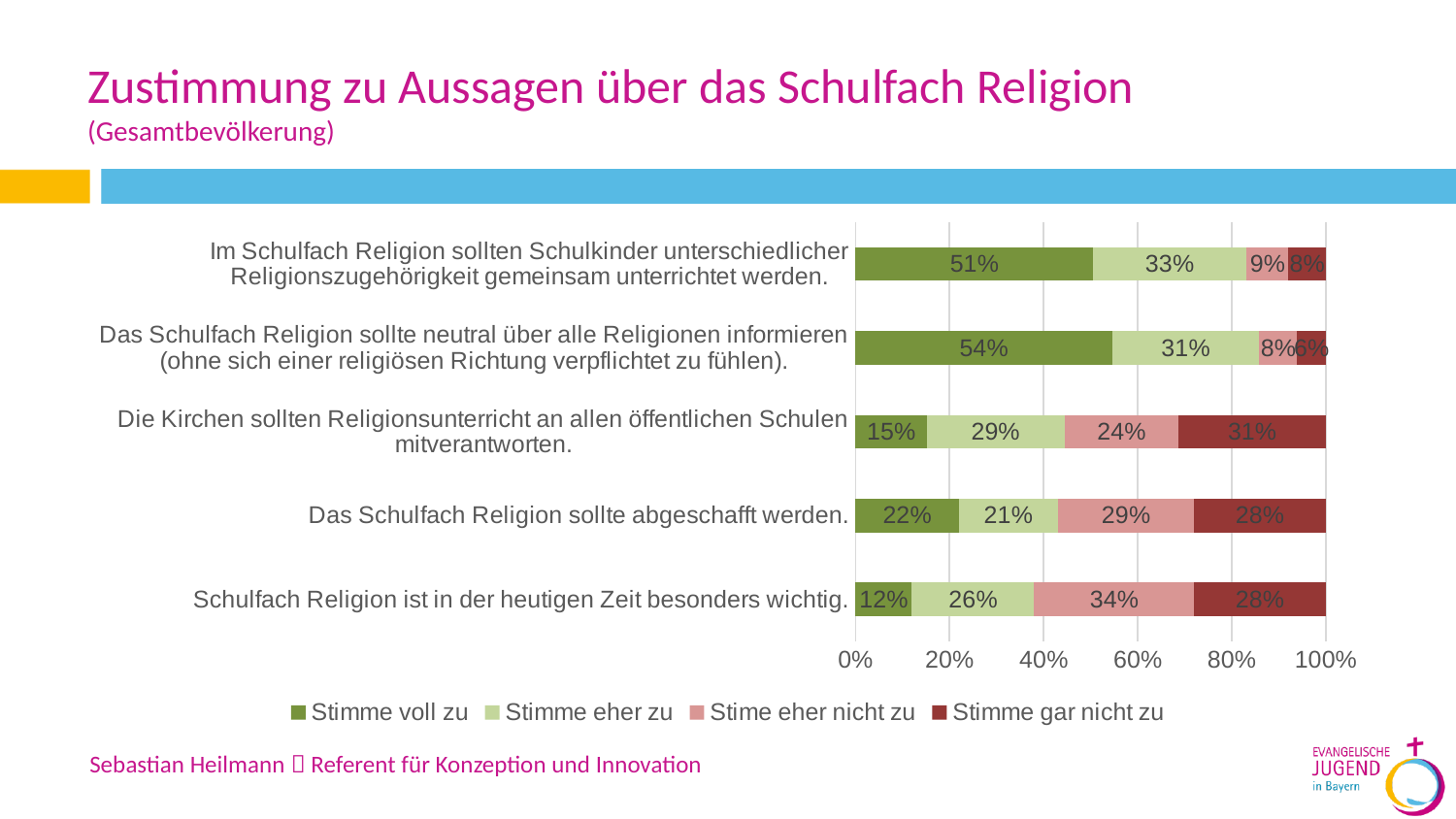
Which statement has the lowest 'Stimme voll zu' value? Schulfach Religion ist in der heutigen Zeit besonders wichtig. What is the combined share of 'Stimme voll zu' and 'Stimme eher zu' for 'Im Schulfach Religion sollten Schulkinder unterschiedlicher Religionszugehörigkeit gemeinsam unterrichtet werden'? 84% Which statement has the highest 'Stimme voll zu' value? Das Schulfach Religion sollte neutral über alle Religionen informieren (ohne sich einer religiösen Richtung verpflichtet zu fühlen). What is the 'Stimme gar nicht zu' value for 'Die Kirchen sollten Religionsunterricht an allen öffentlichen Schulen mitverantworten'? 31% What is the 'Stimme voll zu' value for 'Das Schulfach Religion sollte neutral über alle Religionen informieren'? 54% Which is larger: the 'Stimme eher zu' value for 'Im Schulfach Religion sollten Schulkinder unterschiedlicher Religionszugehörigkeit gemeinsam unterrichtet werden' or for 'Schulfach Religion ist in der heutigen Zeit besonders wichtig'? Im Schulfach Religion sollten Schulkinder unterschiedlicher Religionszugehörigkeit gemeinsam unterrichtet werden. How many statements (categories) are plotted in the chart? 5 What is the difference between the 'Stimme voll zu' values for 'Das Schulfach Religion sollte abgeschafft werden' and 'Die Kirchen sollten Religionsunterricht an allen öffentlichen Schulen mitverantworten'? 7% What type of chart is shown on the slide? Stacked bar chart How many series does the legend list? 4 What is the 'Stimme eher zu' value for 'Das Schulfach Religion sollte abgeschafft werden'? 21% What is the 'Stime eher nicht zu' value for 'Schulfach Religion ist in der heutigen Zeit besonders wichtig'? 34%